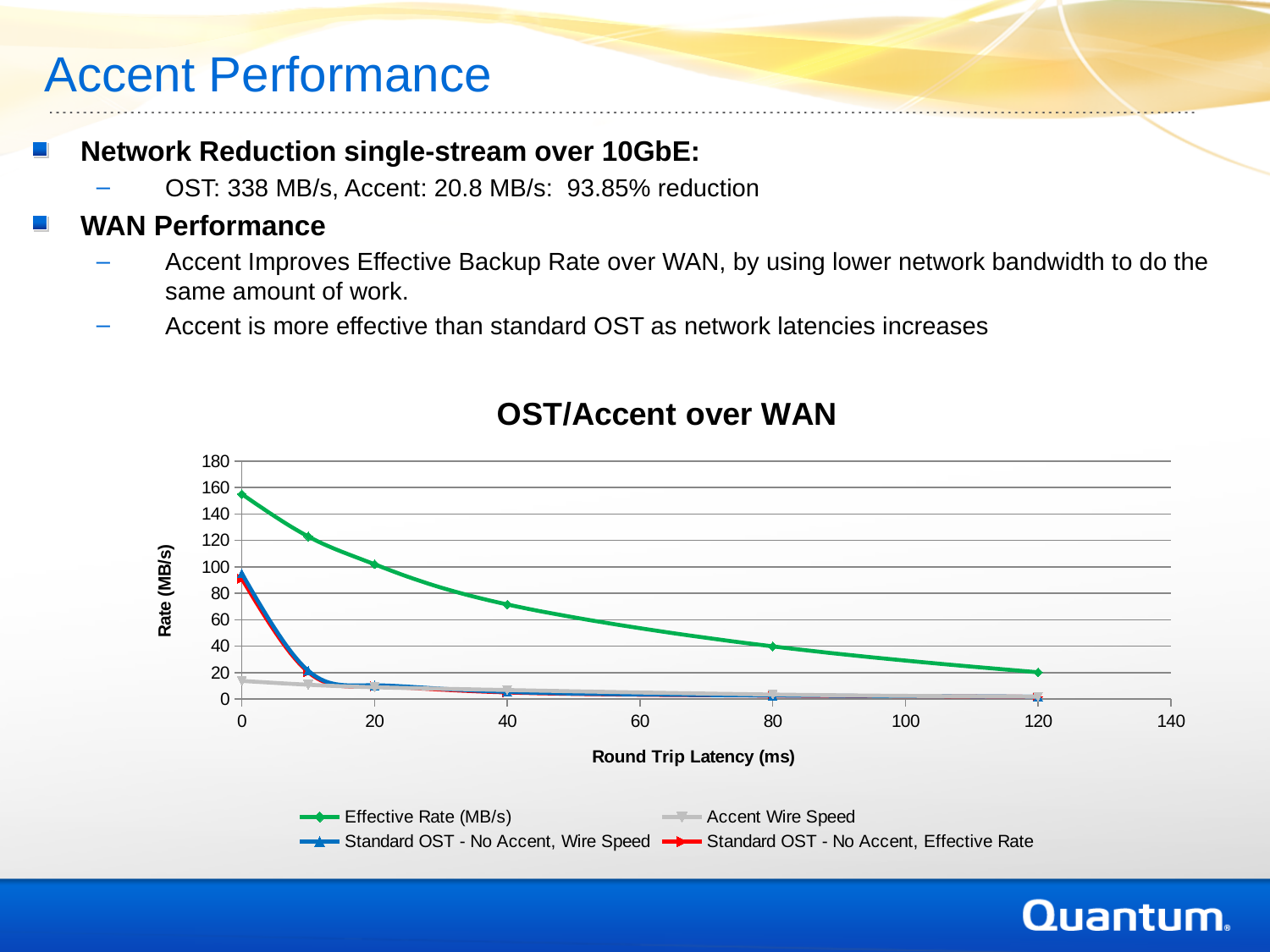
What is the title of the chart? OST/Accent over WAN Is the Accent Wire Speed value at 0 ms latency greater or less than 20? less Does the Effective Rate (MB/s) series rise or fall as Round Trip Latency increases? fall Is the Effective Rate (MB/s) value at 40 ms latency greater or less than 60? greater Which series has the highest value at 40 ms latency? Effective Rate (MB/s) Is the Standard OST - No Accent, Wire Speed value at 0 ms latency greater or less than 80? greater How many data points are plotted for the Effective Rate (MB/s) series? 6 What kind of chart is shown on the slide? line chart At 0 ms latency, which is larger: Effective Rate (MB/s) or Accent Wire Speed? Effective Rate (MB/s) What is the label of the chart's x axis? Round Trip Latency (ms) How many series does the chart's legend list? 4